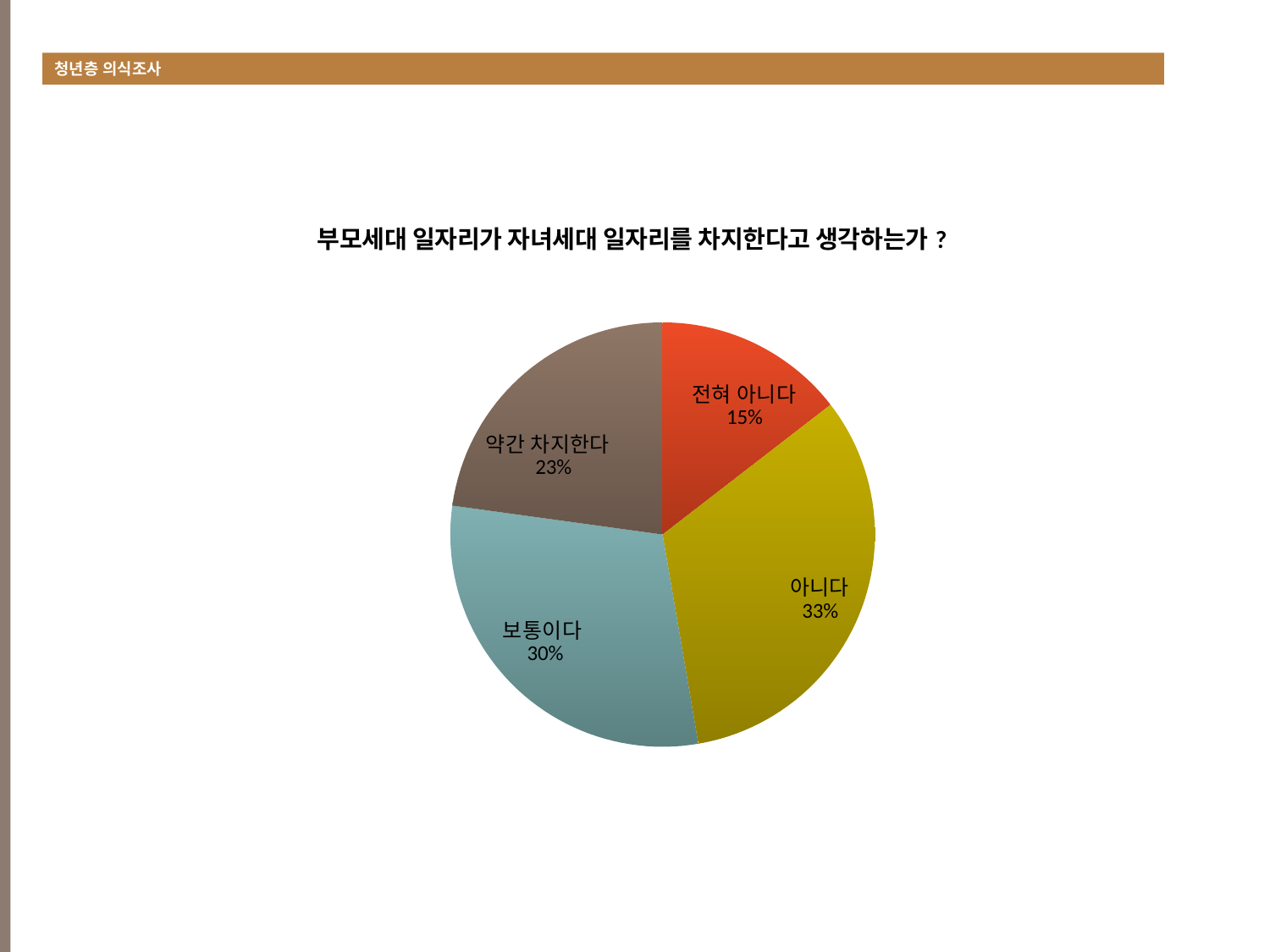
What is the title of the chart? 부모세대 일자리가 자녀세대 일자리를 차지한다고 생각하는가 ? What percentage of respondents answered 보통이다? 30% What percentage of respondents answered 약간 차지한다? 23% How many response categories are shown in the pie chart? 4 Which response has the largest share of the pie? 아니다 What type of chart is shown on the slide? Pie chart What is the difference in percentage points between 보통이다 and 약간 차지한다? 7 Which response has the smallest share of the pie? 전혀 아니다 What percentage of respondents answered 전혀 아니다? 15% What percentage of respondents answered 아니다? 33% What is the difference in percentage points between 아니다 and 전혀 아니다? 18 Which is larger, the share for 보통이다 or the share for 약간 차지한다? 보통이다